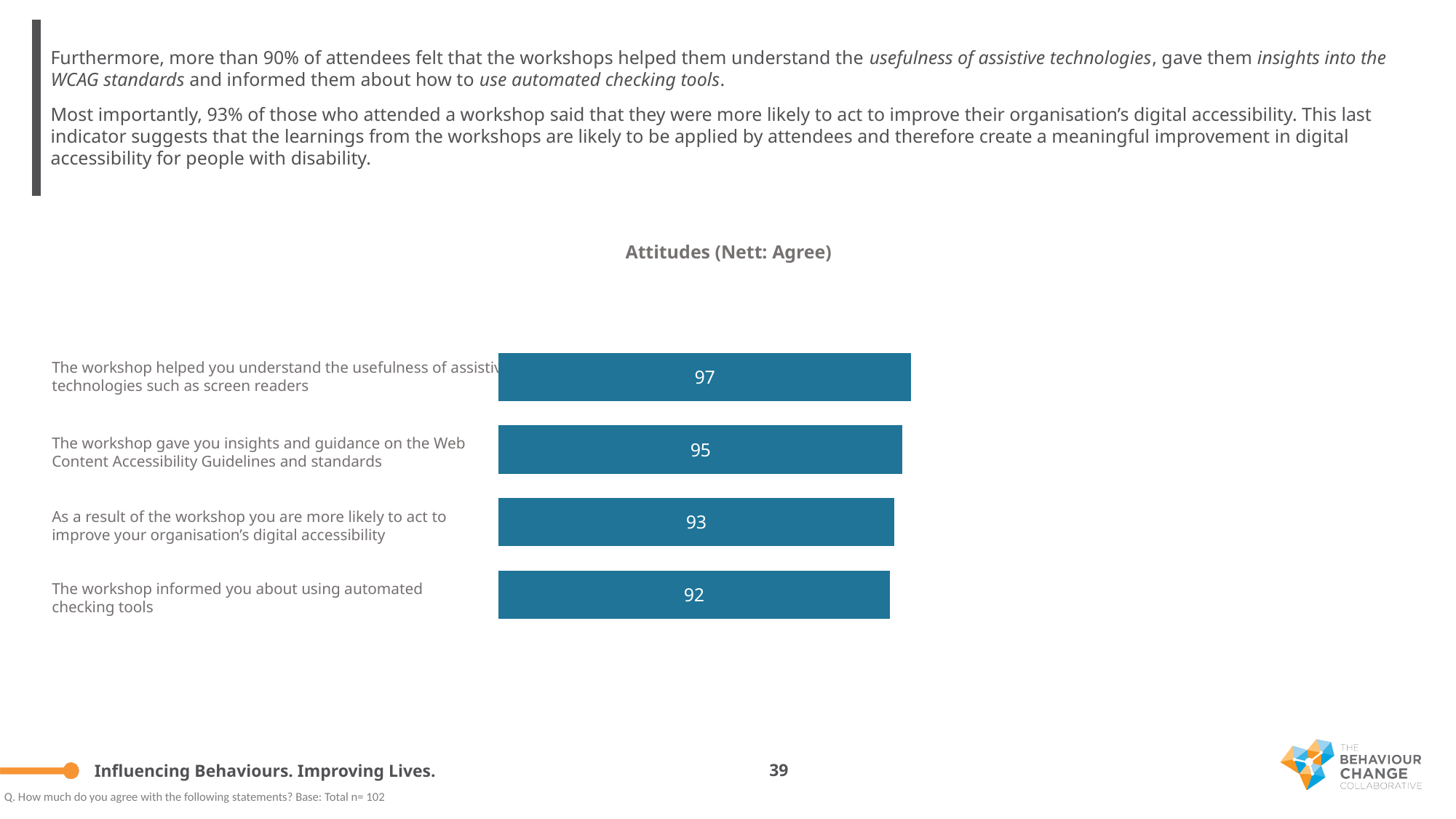
How many statements are shown in the chart? 4 What is the title of the chart? Attitudes (Nett: Agree) Which statement has the highest value? The workshop helped you understand the usefulness of assistive technologies such as screen readers What is the difference between the value for the WCAG statement and the 'more likely to act' statement? 2 What is the value for 'The workshop helped you understand the usefulness of assistive technologies such as screen readers'? 97 What kind of chart is shown on the slide? Bar chart What is the value for 'As a result of the workshop you are more likely to act to improve your organisation's digital accessibility'? 93 Which is larger: the value for the Web Content Accessibility Guidelines statement or the value for the automated checking tools statement? The Web Content Accessibility Guidelines statement Which statement has the lowest value? The workshop informed you about using automated checking tools What is the difference between the value for the assistive technologies statement and the automated checking tools statement? 5 What is the value for 'The workshop informed you about using automated checking tools'? 92 What is the value for 'The workshop gave you insights and guidance on the Web Content Accessibility Guidelines and standards'? 95